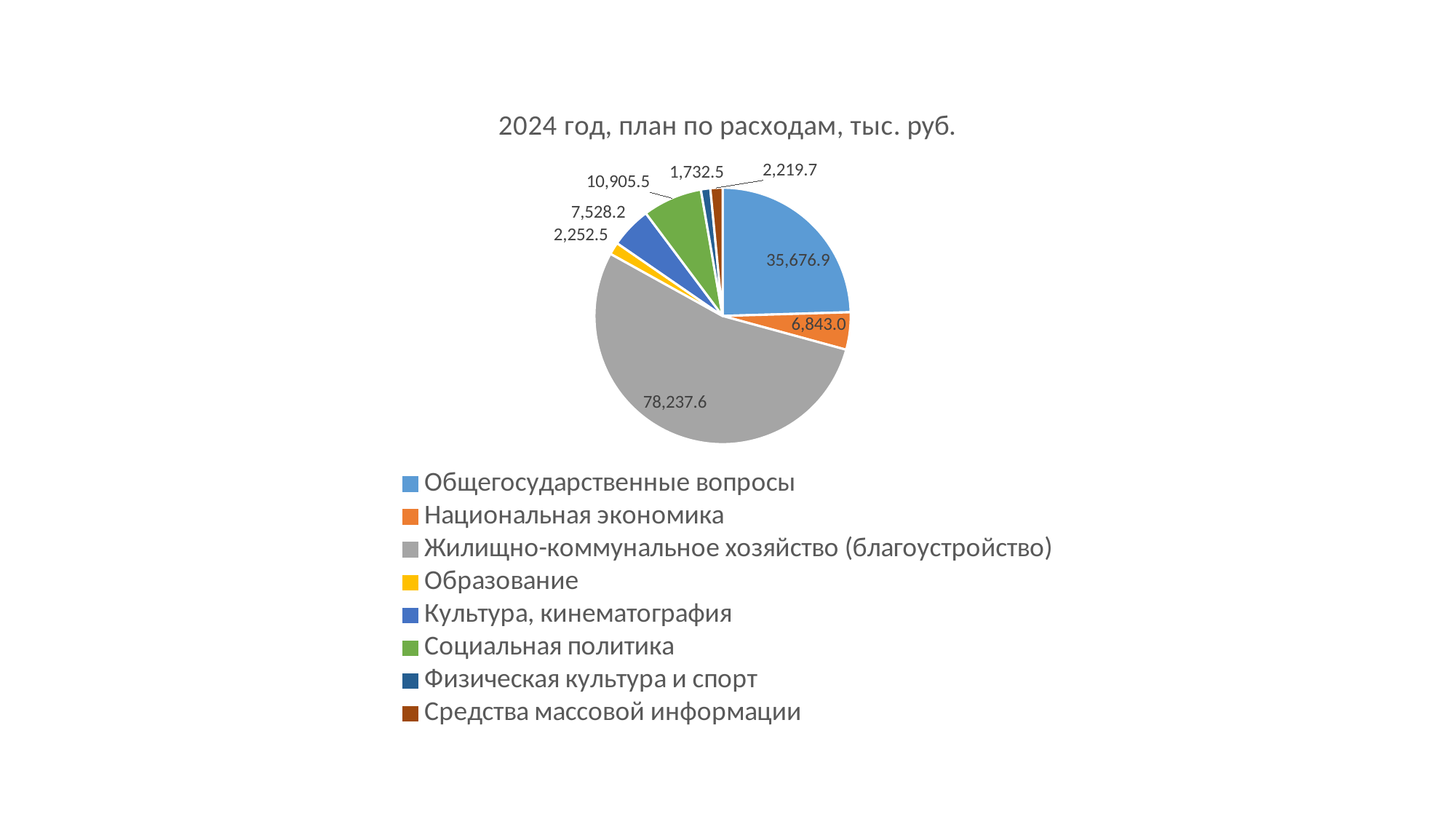
What type of chart is shown on the slide? pie chart What colour is the slice for Образование? yellow What is the value for Национальная экономика? 6,843.0 What is the value for Жилищно-коммунальное хозяйство (благоустройство)? 78,237.6 What is the value for Социальная политика? 10,905.5 What is the difference between Жилищно-коммунальное хозяйство (благоустройство) and Общегосударственные вопросы? 42,560.7 Which is larger, Культура, кинематография or Социальная политика? Социальная политика How many categories does the legend list? 8 Which category has the smallest slice? Физическая культура и спорт What is the value for Общегосударственные вопросы? 35,676.9 What is the title of the chart? 2024 год, план по расходам, тыс. руб. Which category has the largest slice? Жилищно-коммунальное хозяйство (благоустройство)